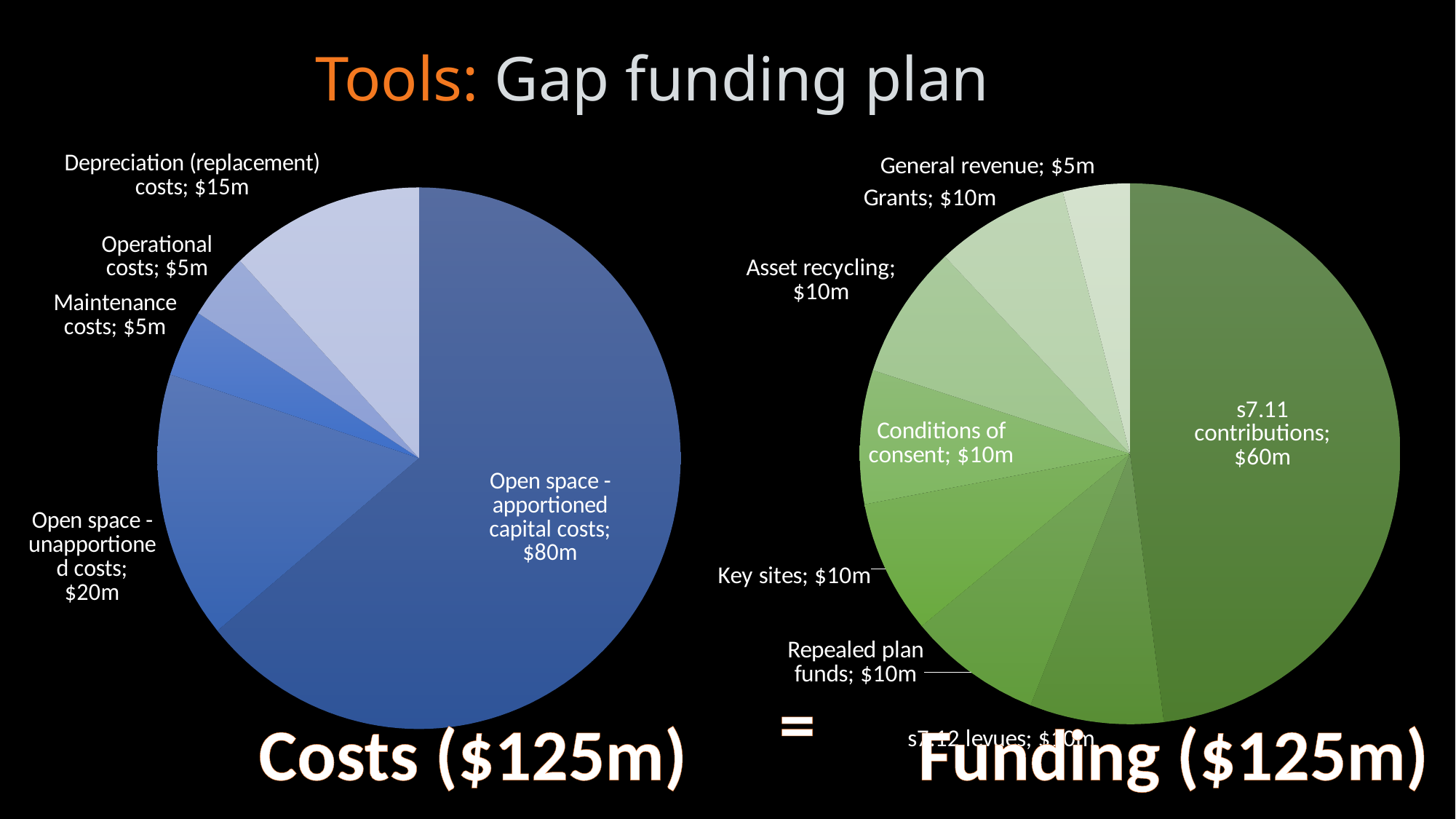
How many slices does the Costs ($125m) pie chart have? 5 How many slices does the Funding ($125m) pie chart have? 8 What type of chart is used for Costs ($125m)? Pie chart In the Costs ($125m) pie chart, what is the difference between Open space - apportioned capital costs and Open space - unapportioned costs? $60m In the Funding ($125m) pie chart, what is the value for s7.11 contributions? $60m In the Costs ($125m) pie chart, what is the value for Depreciation (replacement) costs? $15m In the Costs ($125m) pie chart, what is the value for Open space - apportioned capital costs? $80m In the Funding ($125m) pie chart, what share of the total is s7.11 contributions? 48% In the Costs ($125m) pie chart, which category has the highest value? Open space - apportioned capital costs In the Funding ($125m) pie chart, which category has the lowest value? General revenue In the Funding ($125m) pie chart, which is larger: s7.11 contributions or Grants? s7.11 contributions In the Costs ($125m) pie chart, what share of the total is Open space - apportioned capital costs? 64%